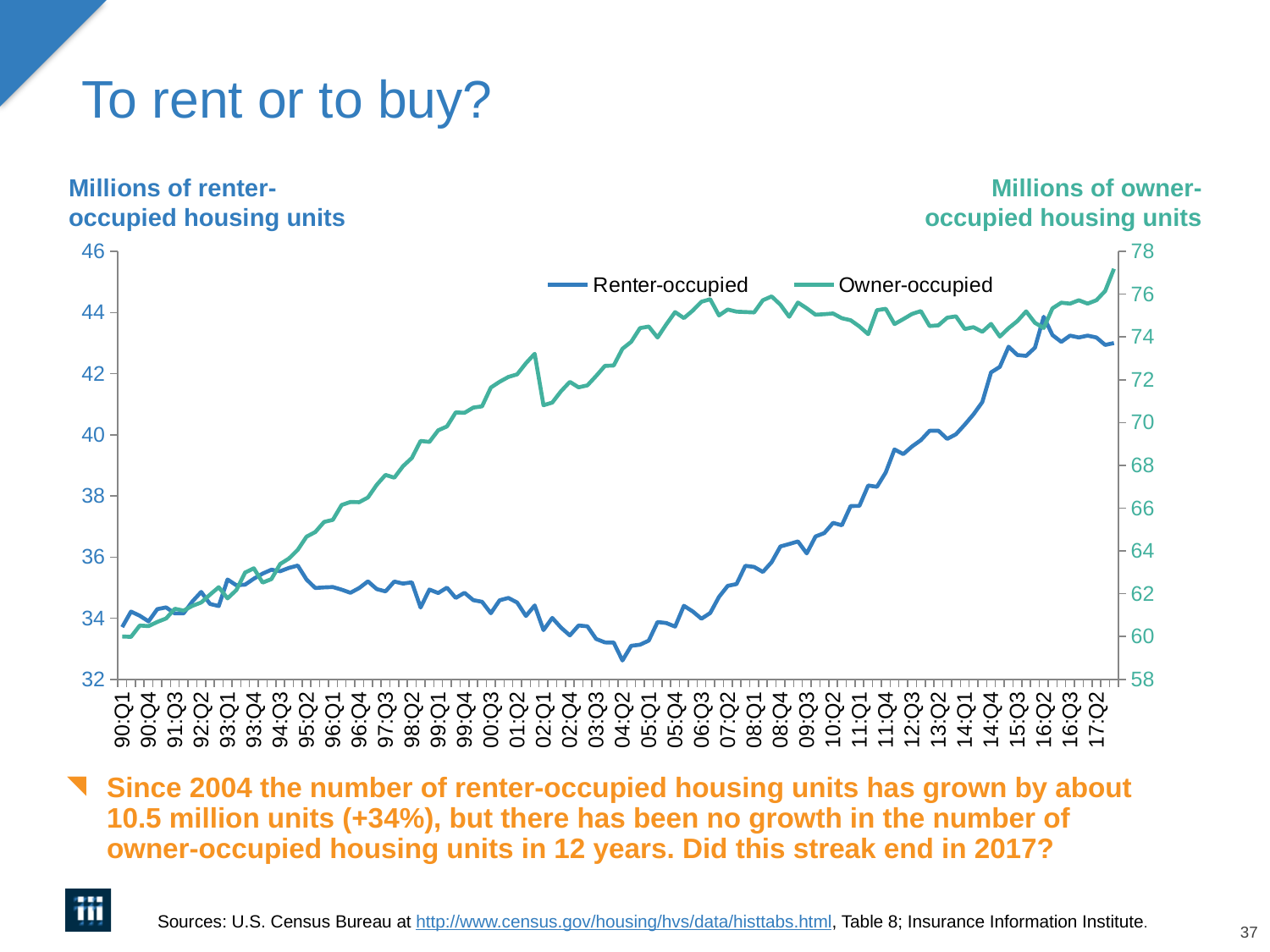
What kind of chart is shown on the slide? Line chart Is the Renter-occupied value at 17:Q2 greater or less than 42? greater Around which quarter does the Renter-occupied line reach its lowest point? 04:Q2 Does the Owner-occupied line rise or fall between 90:Q1 and 06:Q3? rise How many series does the legend list? 2 What is the title of the left vertical axis? Millions of renter-occupied housing units Is the Renter-occupied value at 04:Q2 greater or less than 34? less Does the Renter-occupied line rise or fall between 04:Q2 and 17:Q2? rise What are the two series named in the legend? Renter-occupied and Owner-occupied Is the Owner-occupied value at 90:Q1 greater or less than 62? less